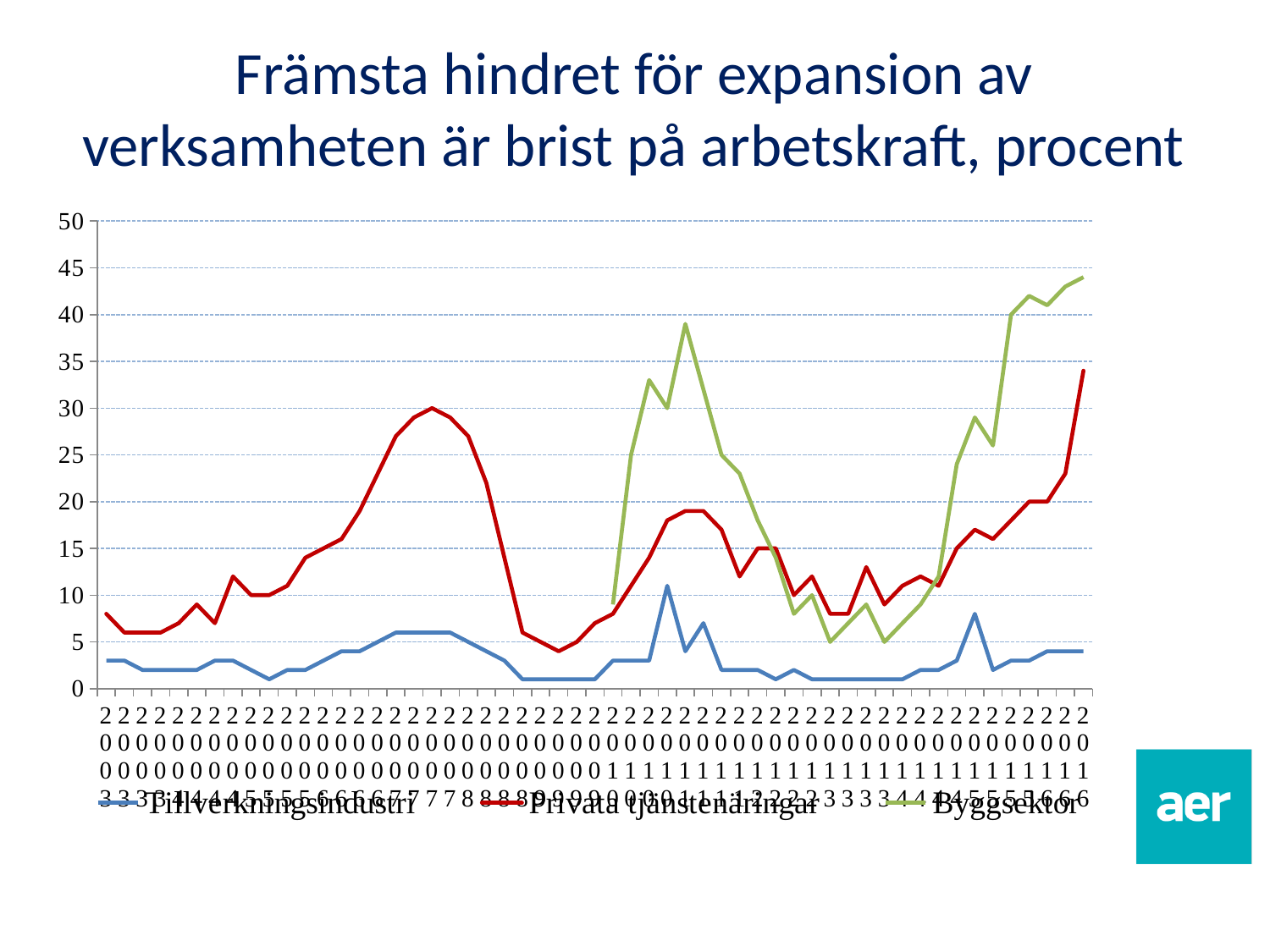
What kind of chart is shown on the slide? line chart Does the Privata tjänstenäringar line rise or fall between its peak around 2007 and 2009? fall Which series is drawn in green? Byggsektor Is the highest value of the Byggsektor line greater or less than 40? greater Is the highest value of the Tillverkningsindustri line greater or less than 15? less Which series stays lowest across the whole chart? Tillverkningsindustri Is the final value of the Privata tjänstenäringar line greater or less than 30? greater Does the Byggsektor line rise or fall over the last few points of the chart? rise What is the title of the chart? Främsta hindret för expansion av verksamheten är brist på arbetskraft, procent Which series reaches the highest value anywhere on the chart? Byggsektor How many series does the legend list? 3 At the right end of the chart, which is higher: Byggsektor or Privata tjänstenäringar? Byggsektor